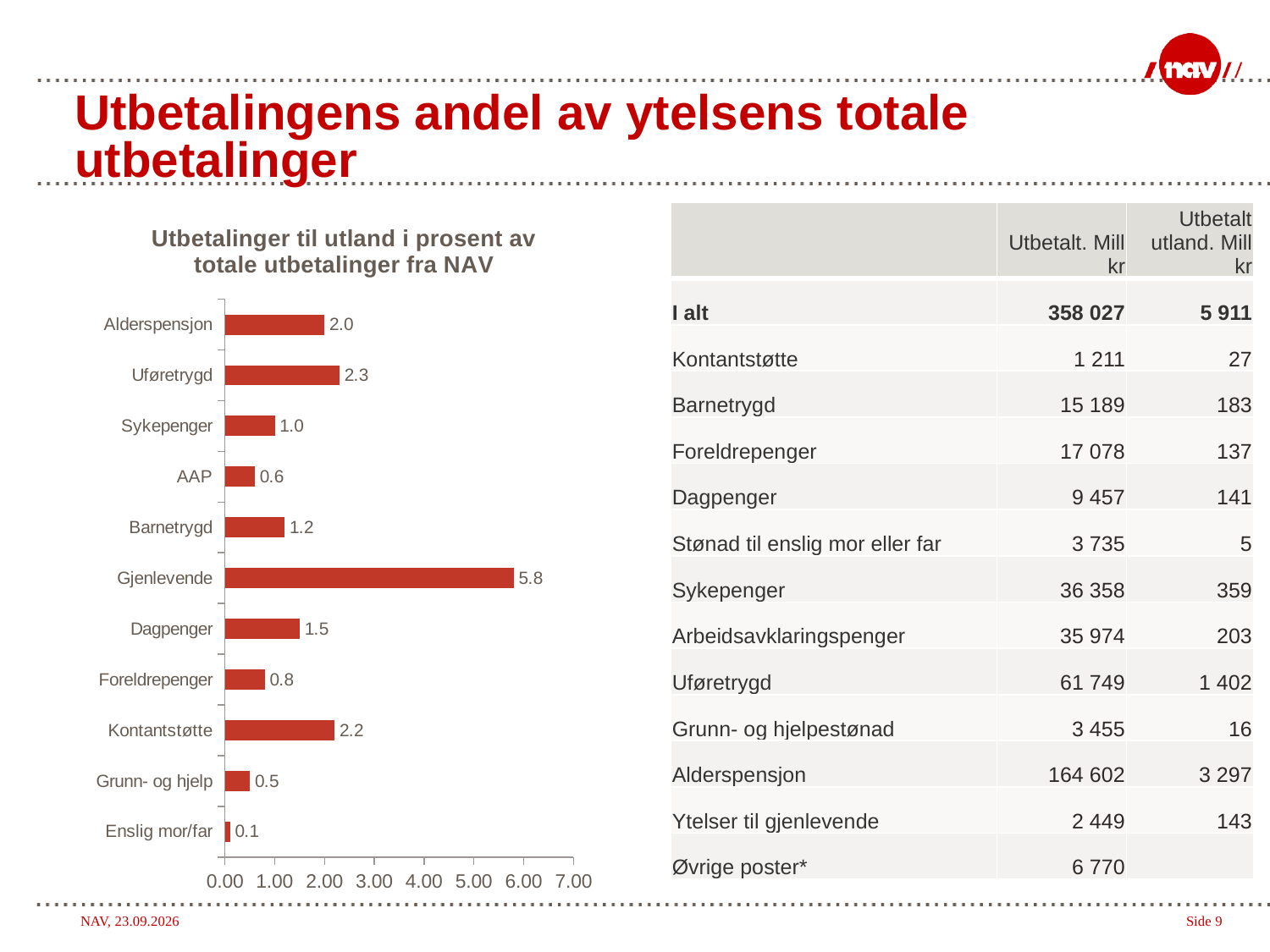
How many categories are shown in the chart? 11 Which is larger, the value for Alderspensjon or the value for Dagpenger? Alderspensjon What kind of chart is shown on the slide? Bar chart What is the title of the chart? Utbetalinger til utland i prosent av totale utbetalinger fra NAV What is the value for Uføretrygd in the chart? 2.3 What is the value for AAP in the chart? 0.6 Which category has the lowest value in the chart? Enslig mor/far Is the value for Gjenlevende greater or less than 5.00? greater What is the difference between the values for Gjenlevende and Uføretrygd? 3.5 What is the value for Kontantstøtte in the chart? 2.2 Which category has the highest value in the chart? Gjenlevende What is the value for Gjenlevende in the chart? 5.8